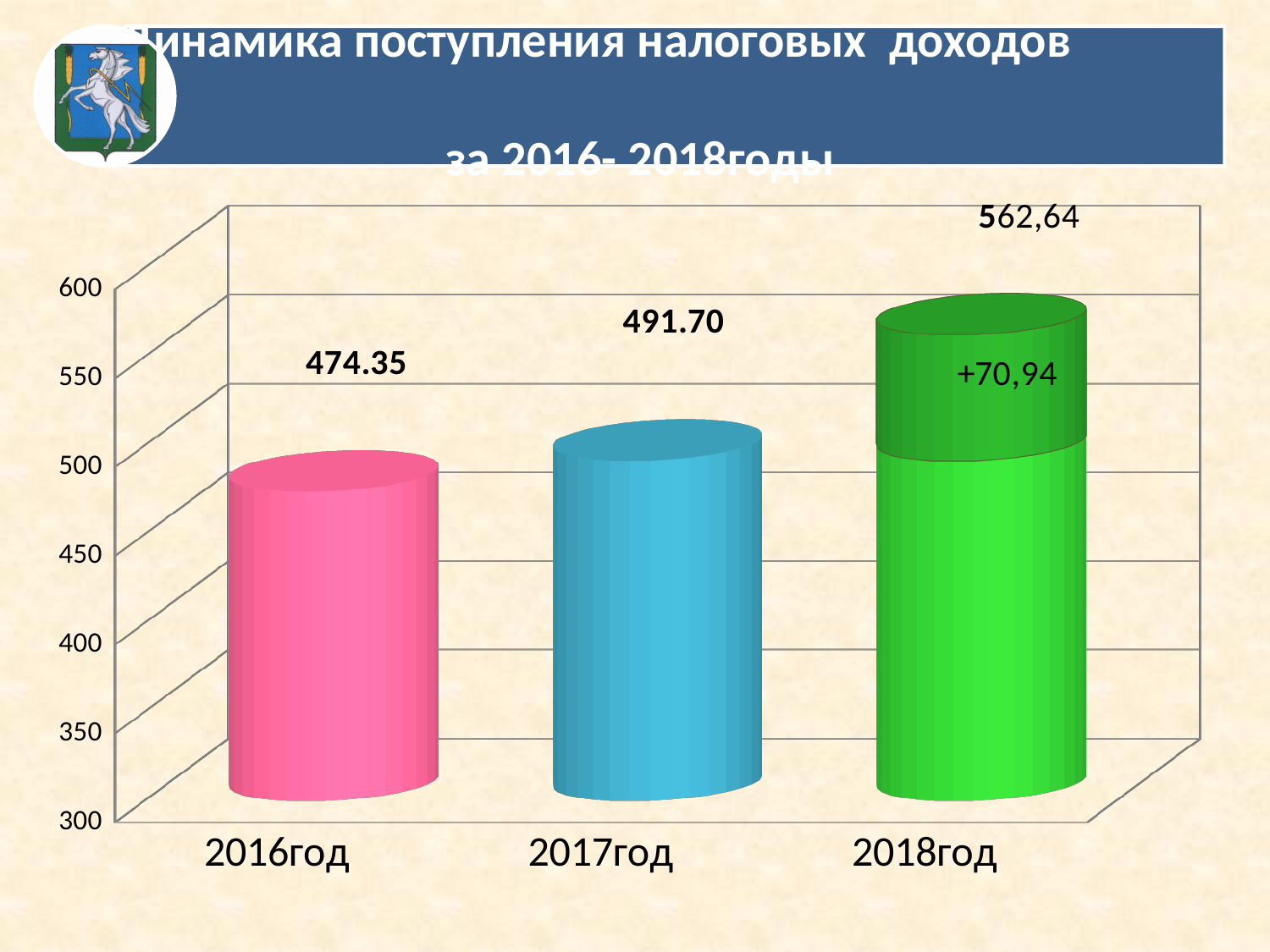
What is the value for 2017год? 491.70 Which is larger, the value for 2017год or the value for 2016год? 2017год Is the value for 2018год greater or less than 550? greater Do the values rise or fall from 2016год to 2018год? rise What is the value for 2016год? 474.35 What is the difference between the values for 2017год and 2016год? 17.35 What is the difference between the values for 2018год and 2017год? 70.94 What kind of chart is shown on the slide? bar chart Which year has the highest value? 2018год How many years are shown on the chart? 3 Which year has the lowest value? 2016год What is the value for 2018год? 562,64